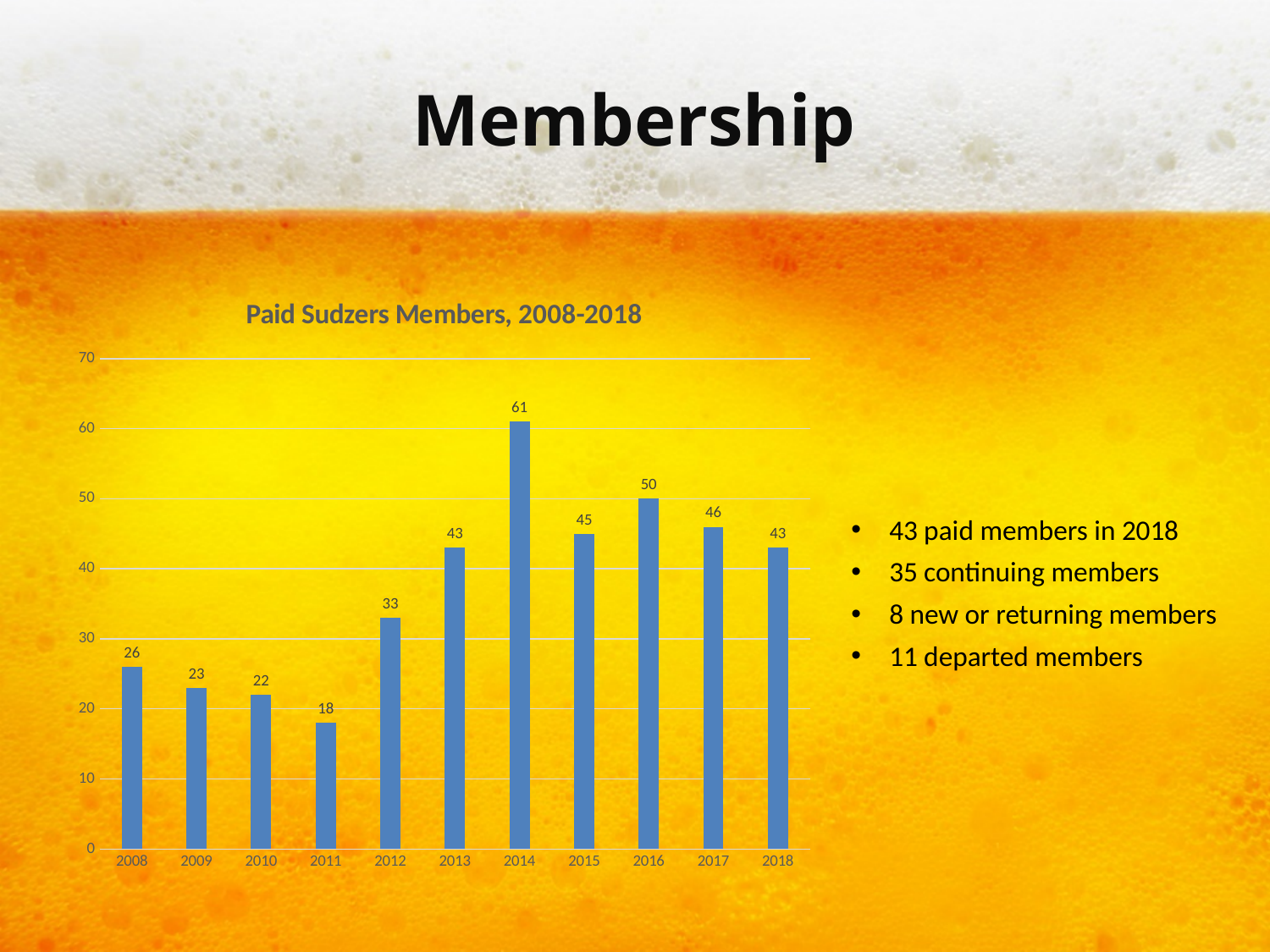
What is the difference between the values for 2014 and 2018? 18 Which year has the lowest number of paid members? 2011 What is the title of the chart? Paid Sudzers Members, 2008-2018 Is the value for 2013 greater or less than 40? greater What kind of chart is shown on the slide? Bar chart What is the difference between the values for 2012 and 2011? 15 How many paid members are shown for 2011? 18 What is the value for 2014 in the Paid Sudzers Members chart? 61 Which is larger, the value for 2015 or the value for 2017? 2017 Which year has the highest number of paid members? 2014 How many years are shown on the x axis of the chart? 11 What is the value for 2016? 50